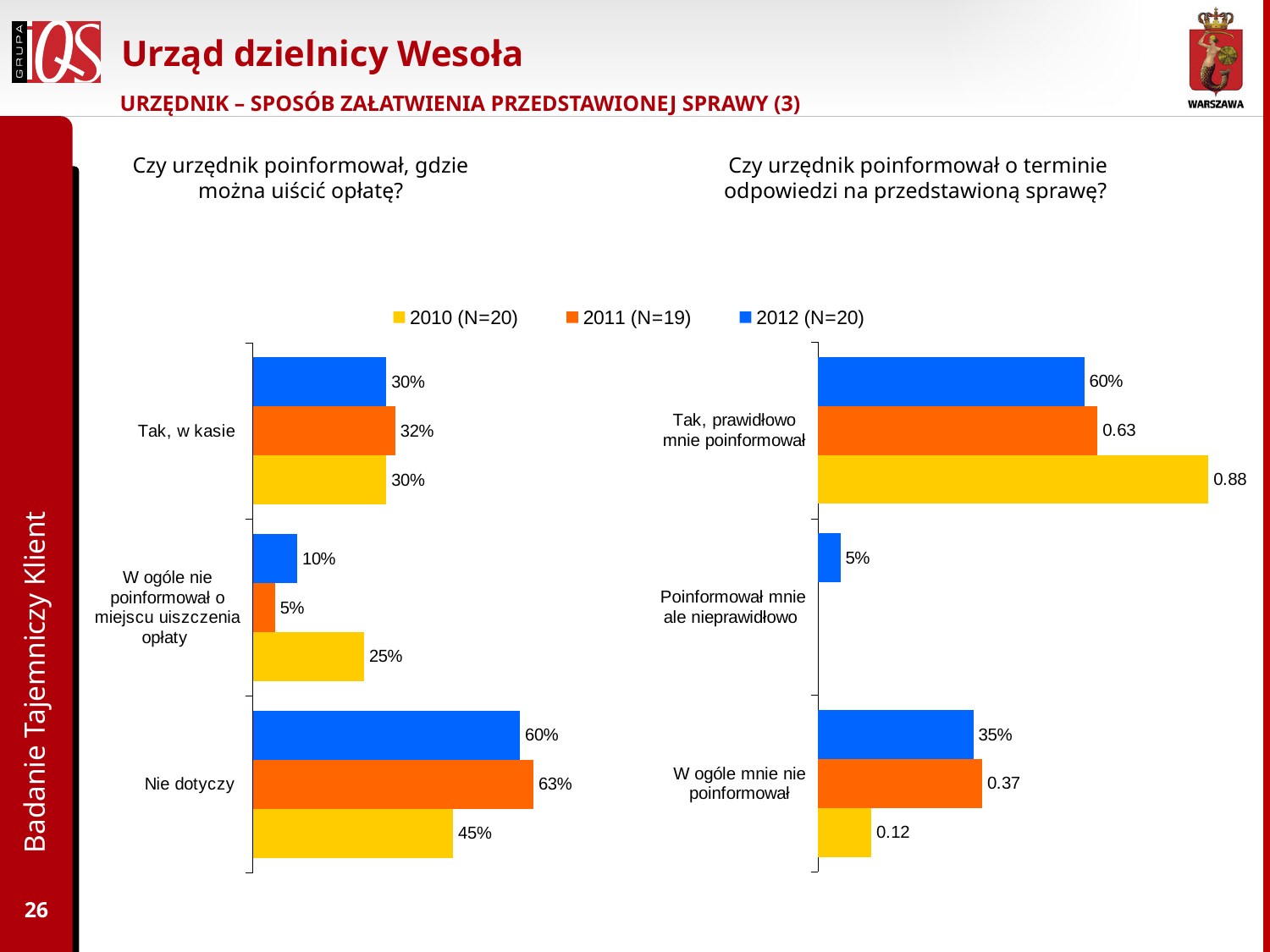
In the left chart (Czy urzędnik poinformował, gdzie można uiścić opłatę?), which category has the lowest value for 2011 (N=19)? W ogóle nie poinformował o miejscu uiszczenia opłaty How many categories are shown in the right chart (Czy urzędnik poinformował o terminie odpowiedzi na przedstawioną sprawę?)? 3 In the right chart (Czy urzędnik poinformował o terminie odpowiedzi na przedstawioną sprawę?), what is the value for 'W ogóle mnie nie poinformował' in 2012 (N=20)? 35% What kind of chart is the left chart (Czy urzędnik poinformował, gdzie można uiścić opłatę?)? Bar chart In the left chart (Czy urzędnik poinformował, gdzie można uiścić opłatę?), what is the value for 'W ogóle nie poinformował o miejscu uiszczenia opłaty' in 2010 (N=20)? 25% Which colour represents the 2011 (N=19) series in the legend? Orange In the left chart (Czy urzędnik poinformował, gdzie można uiścić opłatę?), what is the difference between the 2011 (N=19) and 2010 (N=20) values for 'Nie dotyczy'? 18% How many series does the legend list? 3 In the right chart (Czy urzędnik poinformował o terminie odpowiedzi na przedstawioną sprawę?), what is the value for 'Tak, prawidłowo mnie poinformował' in 2010 (N=20)? 0.88 In the left chart (Czy urzędnik poinformował, gdzie można uiścić opłatę?), which category has the highest value for 2012 (N=20)? Nie dotyczy In the right chart (Czy urzędnik poinformował o terminie odpowiedzi na przedstawioną sprawę?), which is larger for 'W ogóle mnie nie poinformował': the 2011 (N=19) value or the 2010 (N=20) value? 2011 (N=19) In the left chart (Czy urzędnik poinformował, gdzie można uiścić opłatę?), what is the value for 'Nie dotyczy' in 2011 (N=19)? 63%